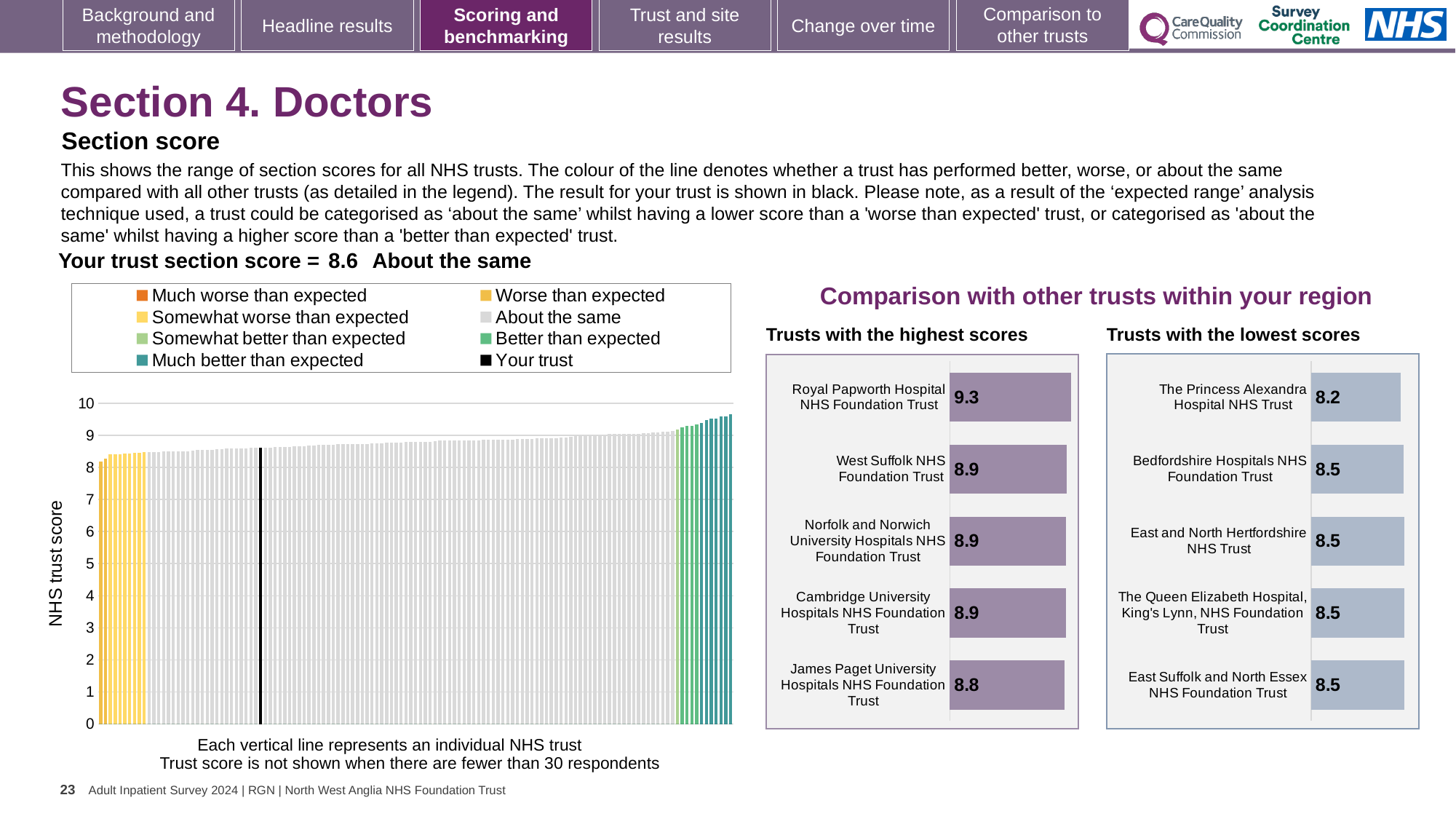
What kind of chart is the 'Trusts with the lowest scores' chart? Bar chart How many entries does the legend of the main chart on the left list? 8 In the legend of the main chart on the left, what colour represents 'Your trust'? Black In the 'Trusts with the highest scores' chart, which trust has the highest score? Royal Papworth Hospital NHS Foundation Trust In the 'Trusts with the highest scores' chart, what is the score for Royal Papworth Hospital NHS Foundation Trust? 9.3 In the 'Trusts with the lowest scores' chart, what is the score for The Princess Alexandra Hospital NHS Trust? 8.2 In the 'Trusts with the highest scores' chart, how many trusts are shown? 5 In the main chart on the left showing all NHS trusts, what is the section score for your trust? 8.6 In the 'Trusts with the highest scores' chart, what is the difference between the scores of Royal Papworth Hospital NHS Foundation Trust and James Paget University Hospitals NHS Foundation Trust? 0.5 In the main chart on the left showing all NHS trusts, is the value of the tallest bar greater or less than 9? greater In the 'Trusts with the lowest scores' chart, which has the larger score: The Princess Alexandra Hospital NHS Trust or Bedfordshire Hospitals NHS Foundation Trust? Bedfordshire Hospitals NHS Foundation Trust In the 'Trusts with the lowest scores' chart, which trust has the lowest score? The Princess Alexandra Hospital NHS Trust